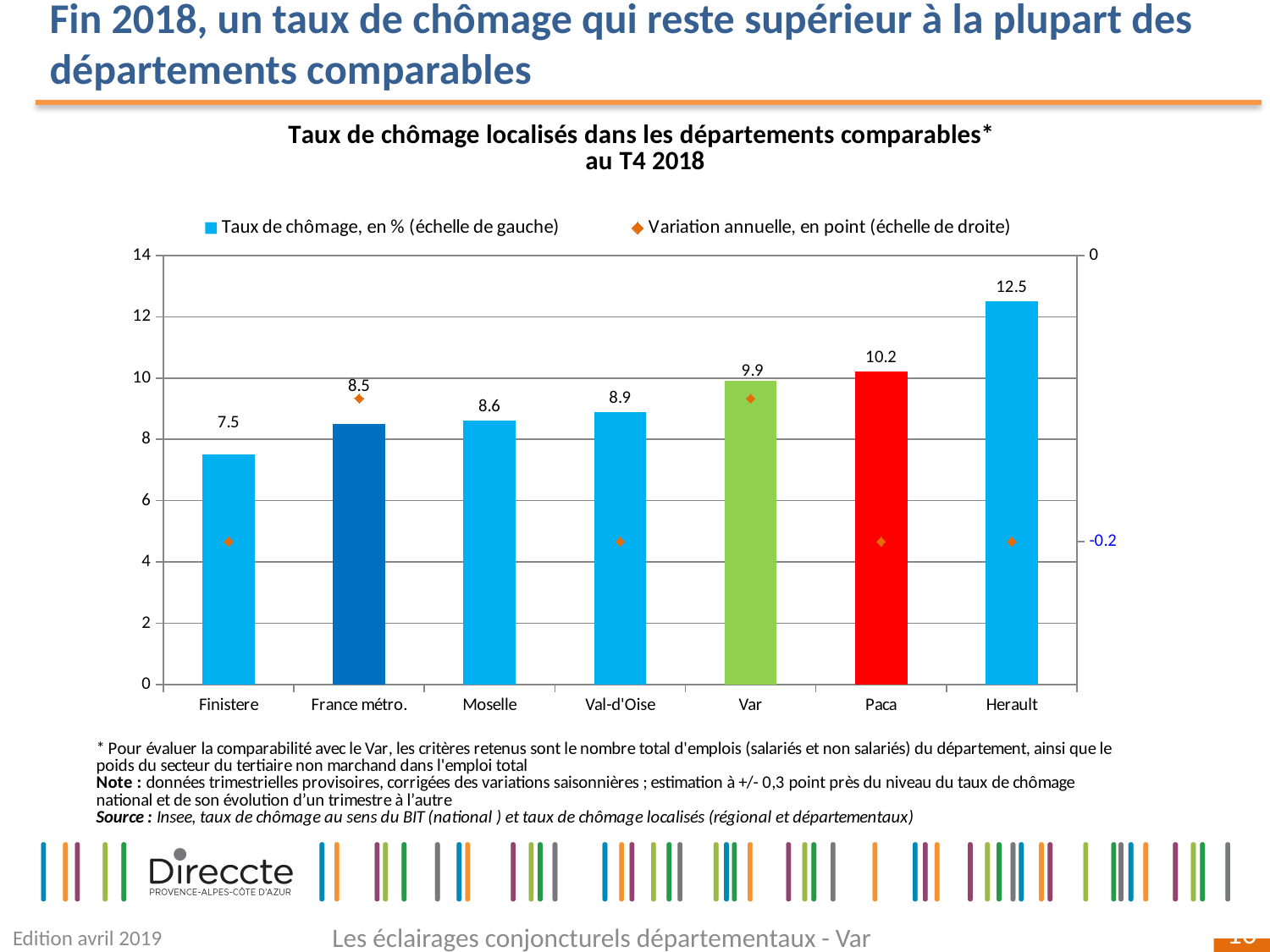
What is the unemployment rate shown for Var? 9.9 Which has a higher unemployment rate, Moselle or Val-d'Oise? Val-d'Oise What is the unemployment rate shown for France métro.? 8.5 What type of chart is used to show the unemployment rates? Bar chart How many series does the legend list? 2 Is the unemployment rate for Paca greater or less than 10? greater What is the unemployment rate (Taux de chômage) shown for Herault? 12.5 Which category has the lowest unemployment rate on the chart? Finistere Which department has the highest unemployment rate on the chart? Herault What is the difference between the unemployment rates of Paca and Var? 0.3 How many categories (departments/areas) are shown on the x axis? 7 What is the difference between the unemployment rates of Herault and Finistere? 5